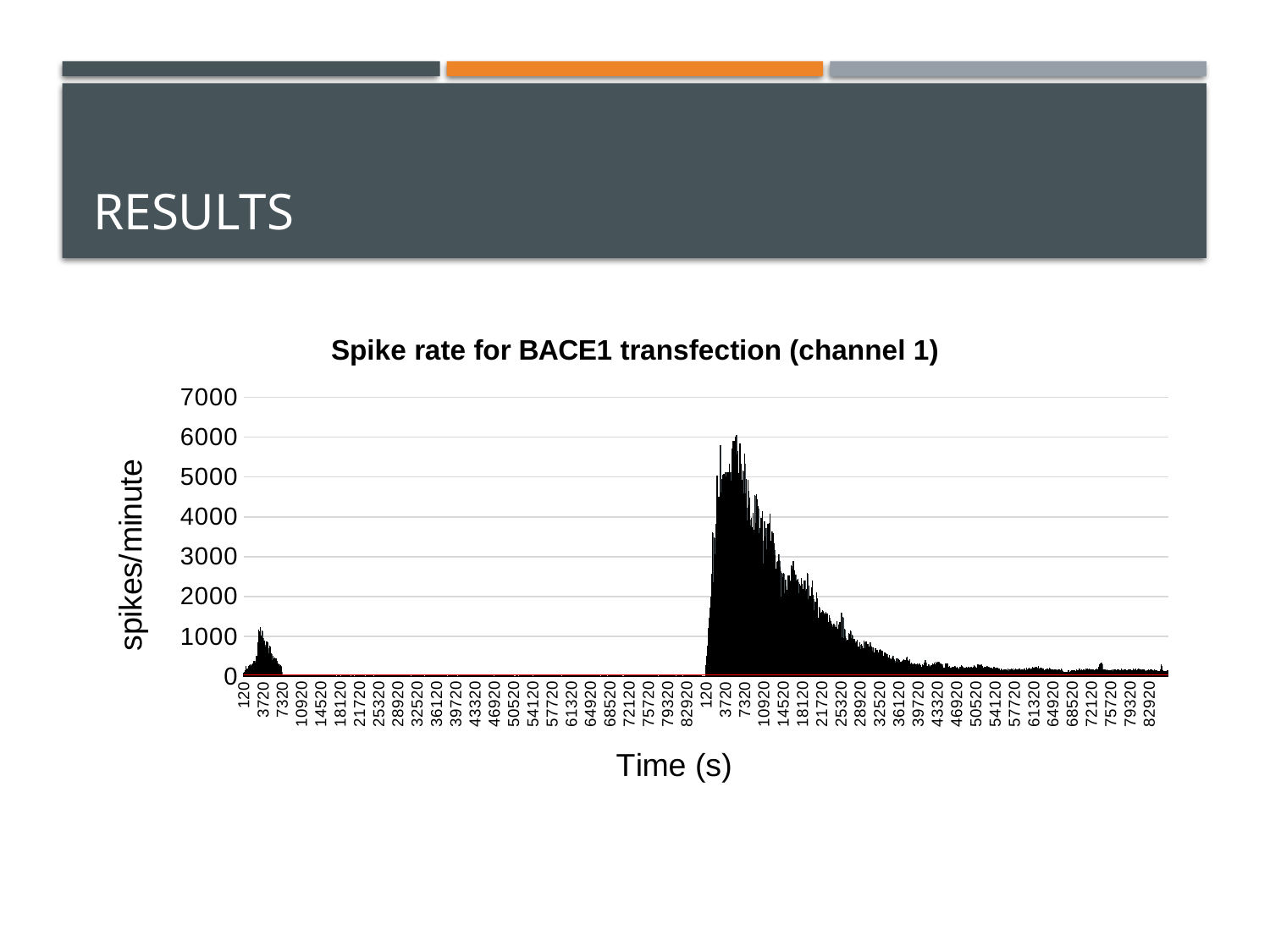
What is the label of the vertical axis? spikes/minute After the large peak in the right-hand half of the chart, do the spike rate values rise or fall as time increases? fall Is the highest spike rate shown in the chart greater or less than 5000 spikes/minute? greater Which burst of activity reaches a higher spike rate, the one on the left of the chart or the one on the right? the one on the right What is the highest value marked on the vertical axis? 7000 What kind of chart is shown on the slide? bar chart What is the title of the chart? Spike rate for BACE1 transfection (channel 1) Is the highest spike rate shown in the chart greater or less than 7000 spikes/minute? less Is the peak of the first (left-hand) burst of activity greater or less than 2000 spikes/minute? less